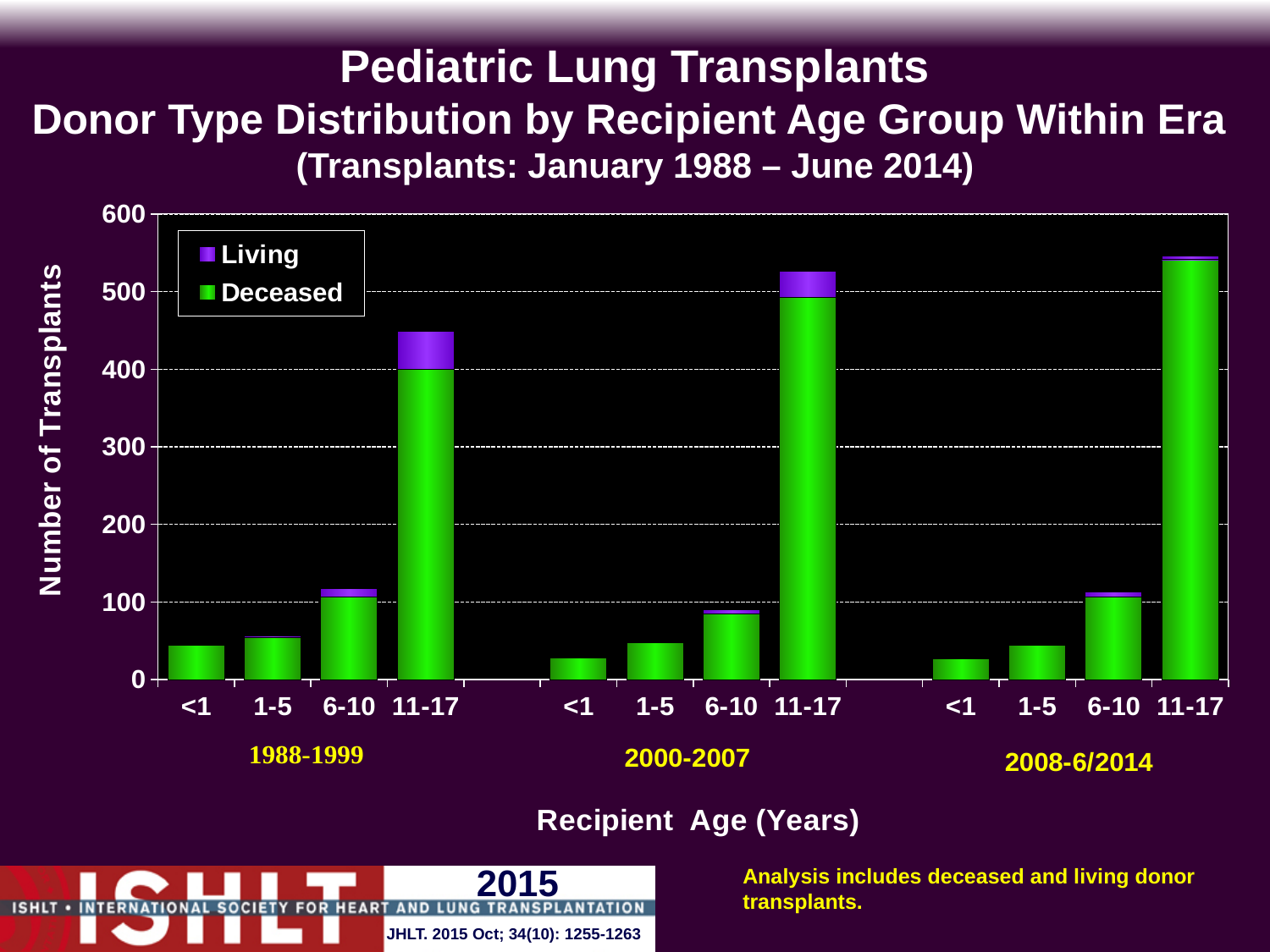
How many bars are plotted in the chart in total across all three eras? 12 Is the total number of transplants for the 6-10 age group in 2000-2007 greater or less than 100? less Is the total number of transplants for the 11-17 age group in 1988-1999 greater or less than 400? greater Which colour represents the Living donor series in the legend? Purple How many series does the legend list? 2 What kind of chart is shown on the slide? Stacked bar chart Within each era, do the bar heights rise or fall as recipient age group increases from <1 to 11-17? rise Which is larger: the 11-17 bar in 2000-2007 or the 11-17 bar in 1988-1999? 11-17 in 2000-2007 Is the total number of transplants for the <1 age group in 2008-6/2014 greater or less than 100? less Which recipient age group has the shortest bar in the 1988-1999 era? <1 Which recipient age group has the tallest bar in the 1988-1999 era? 11-17